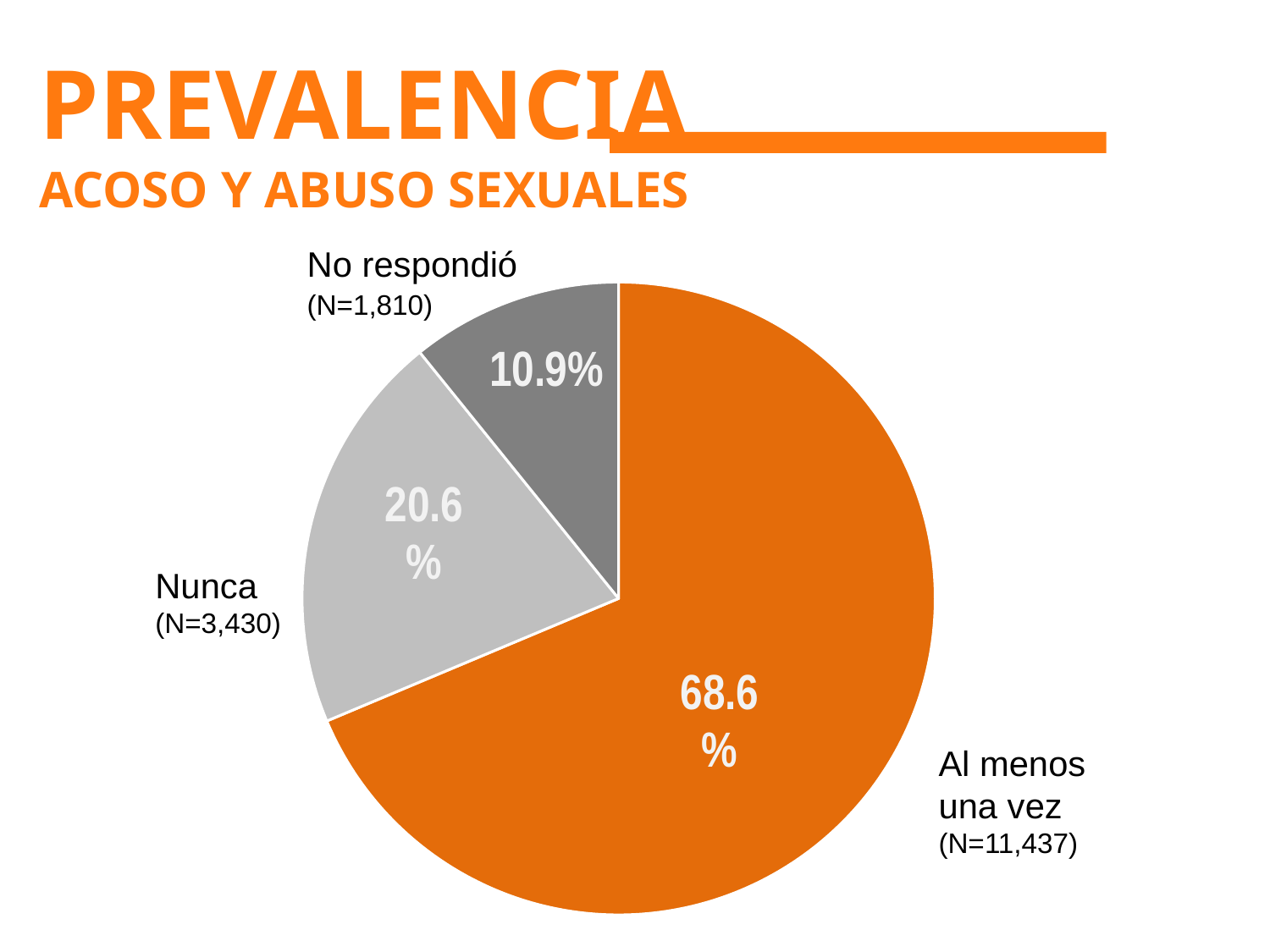
What percentage is shown for the "No respondió" slice? 10.9% What kind of chart is shown on the slide? Pie chart What is the N value given for "Nunca"? N=3,430 Which is larger, the "Nunca" slice or the "No respondió" slice? Nunca Which slice of the pie is the largest? Al menos una vez What is the difference in percentage points between the "Nunca" and "No respondió" slices? 9.7 Which slice of the pie is the smallest? No respondió What is the N value given for "No respondió"? N=1,810 What percentage is shown for the "Nunca" slice? 20.6% What is the N value given for "Al menos una vez"? N=11,437 What percentage of the pie does the "Al menos una vez" slice represent? 68.6% How many slices does the pie chart have? 3